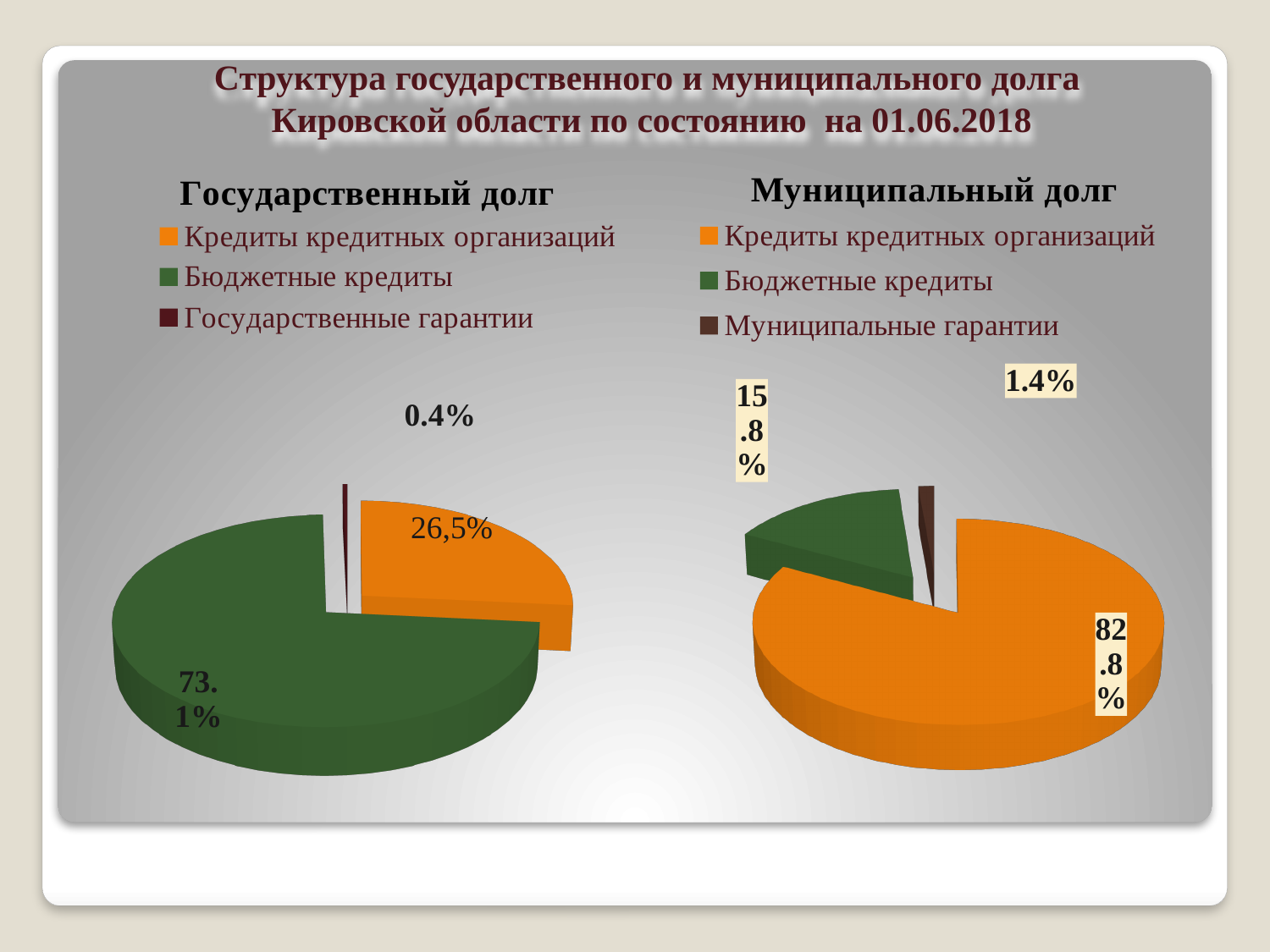
In the "Государственный долг" chart, which category has the largest slice? Бюджетные кредиты In the "Государственный долг" chart, what share is "Кредиты кредитных организаций"? 26,5% How many categories does the legend of the "Муниципальный долг" chart list? 3 What kind of chart is used for "Государственный долг"? pie chart In the "Государственный долг" chart, what share is "Государственные гарантии"? 0.4% In the "Муниципальный долг" chart, what share is "Бюджетные кредиты"? 15.8% In the "Государственный долг" chart, what colour is the "Бюджетные кредиты" slice? green In the "Муниципальный долг" chart, which is larger: "Кредиты кредитных организаций" or "Бюджетные кредиты"? Кредиты кредитных организаций In the "Государственный долг" chart, what share is "Бюджетные кредиты"? 73.1% In the "Муниципальный долг" chart, which category has the smallest slice? Муниципальные гарантии In the "Муниципальный долг" chart, what share is "Кредиты кредитных организаций"? 82.8% In the "Муниципальный долг" chart, what share is "Муниципальные гарантии"? 1.4%